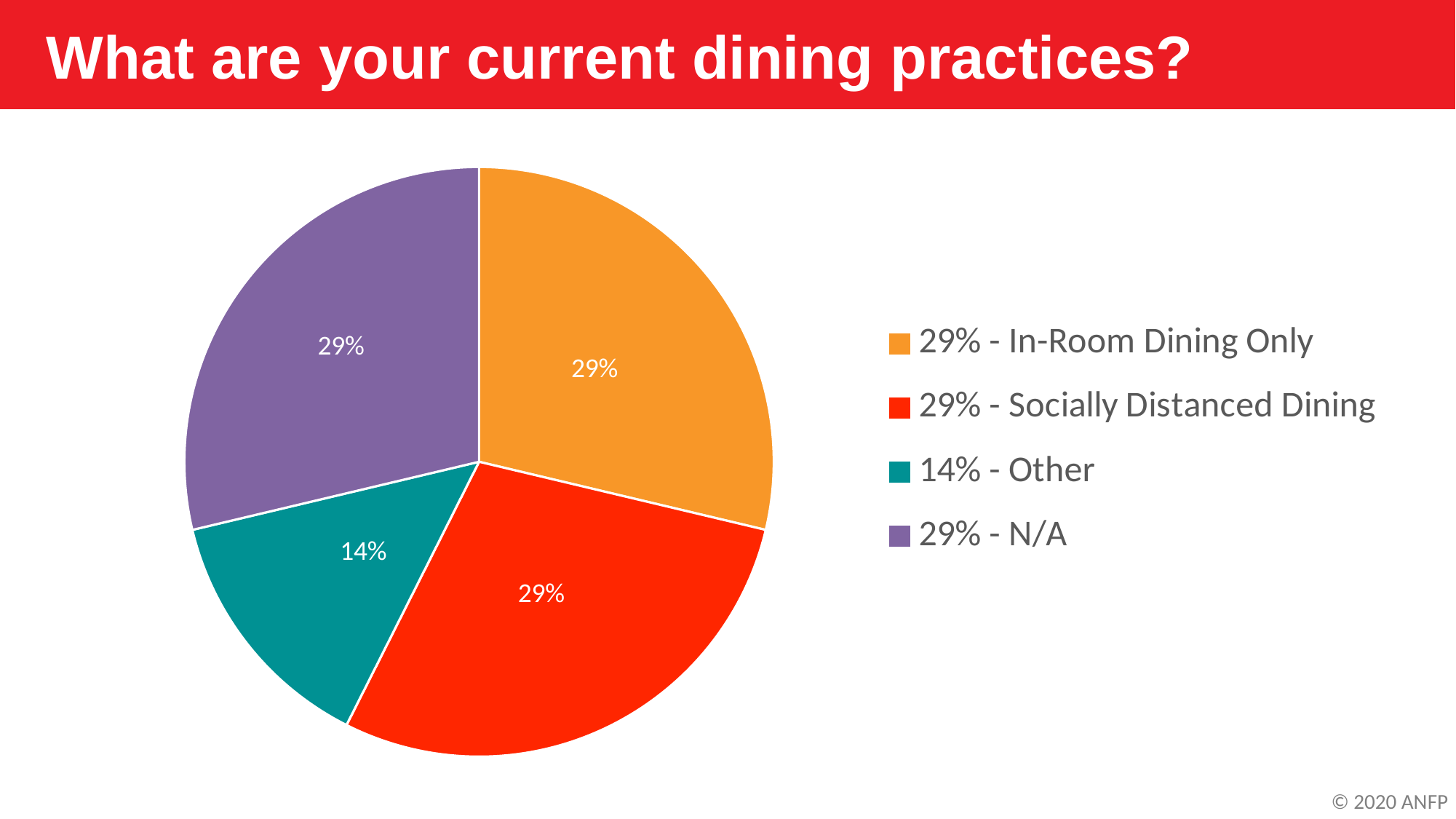
Which is larger, the share for Socially Distanced Dining or the share for Other? Socially Distanced Dining What share of the pie is Other? 14% What is the difference between the share for In-Room Dining Only and the share for Other? 15% What kind of chart is shown on the slide? pie chart What colour is the slice for N/A? purple What share of the pie is Socially Distanced Dining? 29% What is the title of the slide containing the pie chart? What are your current dining practices? Which category has the smallest slice of the pie? Other How many entries does the legend list? 4 How many slices does the pie chart have? 4 What share of the pie is N/A? 29%